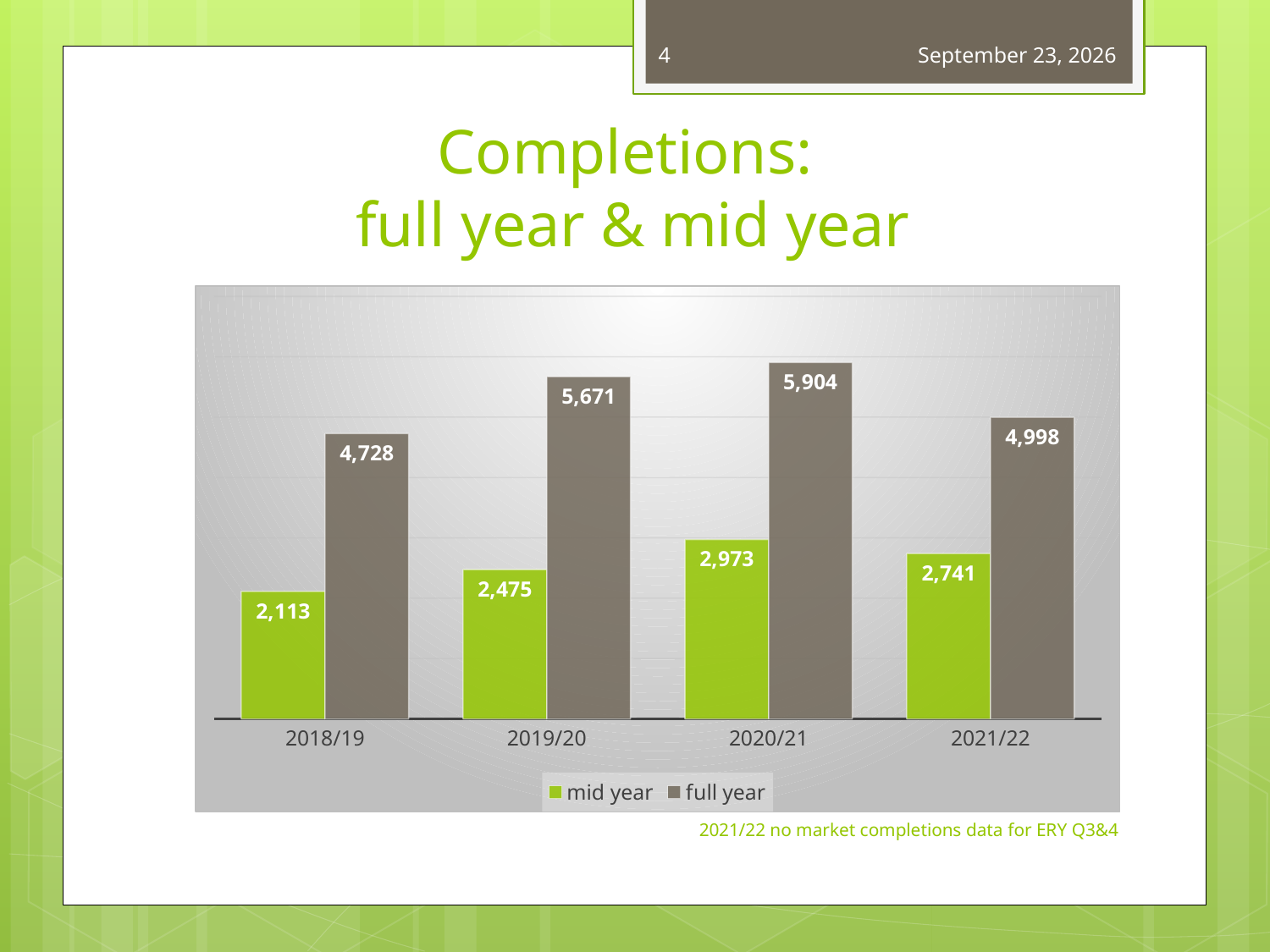
How many years are shown on the x axis? 4 How many series does the legend list? 2 What is the mid year completions value for 2018/19? 2,113 What is the difference between the full year completions for 2020/21 and 2021/22? 906 What is the full year completions value for 2021/22? 4,998 Which year has the lowest mid year completions? 2018/19 Which year has the highest full year completions? 2020/21 What is the full year completions value for 2020/21? 5,904 Which colour represents the mid year series in the legend? green What is the difference between the full year and mid year completions for 2019/20? 3,196 What kind of chart is shown on the slide? bar chart Which is larger, the mid year completions for 2020/21 or for 2021/22? 2020/21